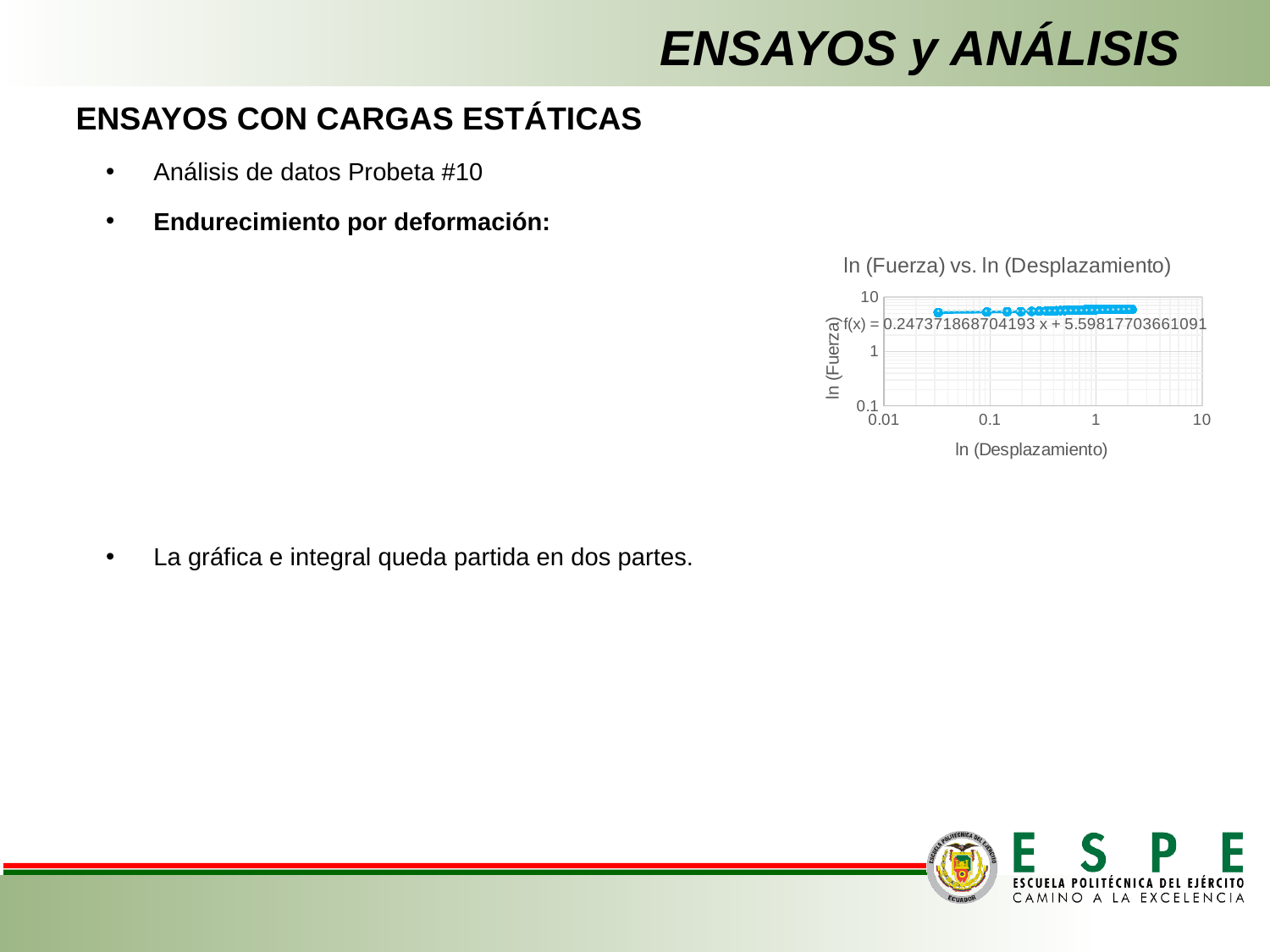
Are the plotted ln (Fuerza) values greater or less than 1? greater What is the title of the chart? ln (Fuerza) vs. ln (Desplazamiento) Are the plotted ln (Fuerza) values greater or less than 10? less What kind of chart is shown on the slide? scatter chart What is the trendline equation shown on the chart? f(x) = 0.247371868704193 x + 5.59817703661091 What is the lowest tick value shown on the vertical axis of the chart? 0.1 What is the slope of the trendline shown on the chart? 0.247371868704193 What is the label of the vertical axis of the chart? ln (Fuerza) What is the intercept of the trendline shown on the chart? 5.59817703661091 Do the plotted values rise or fall as ln (Desplazamiento) increases? rise What is the highest tick value shown on the horizontal axis of the chart? 10